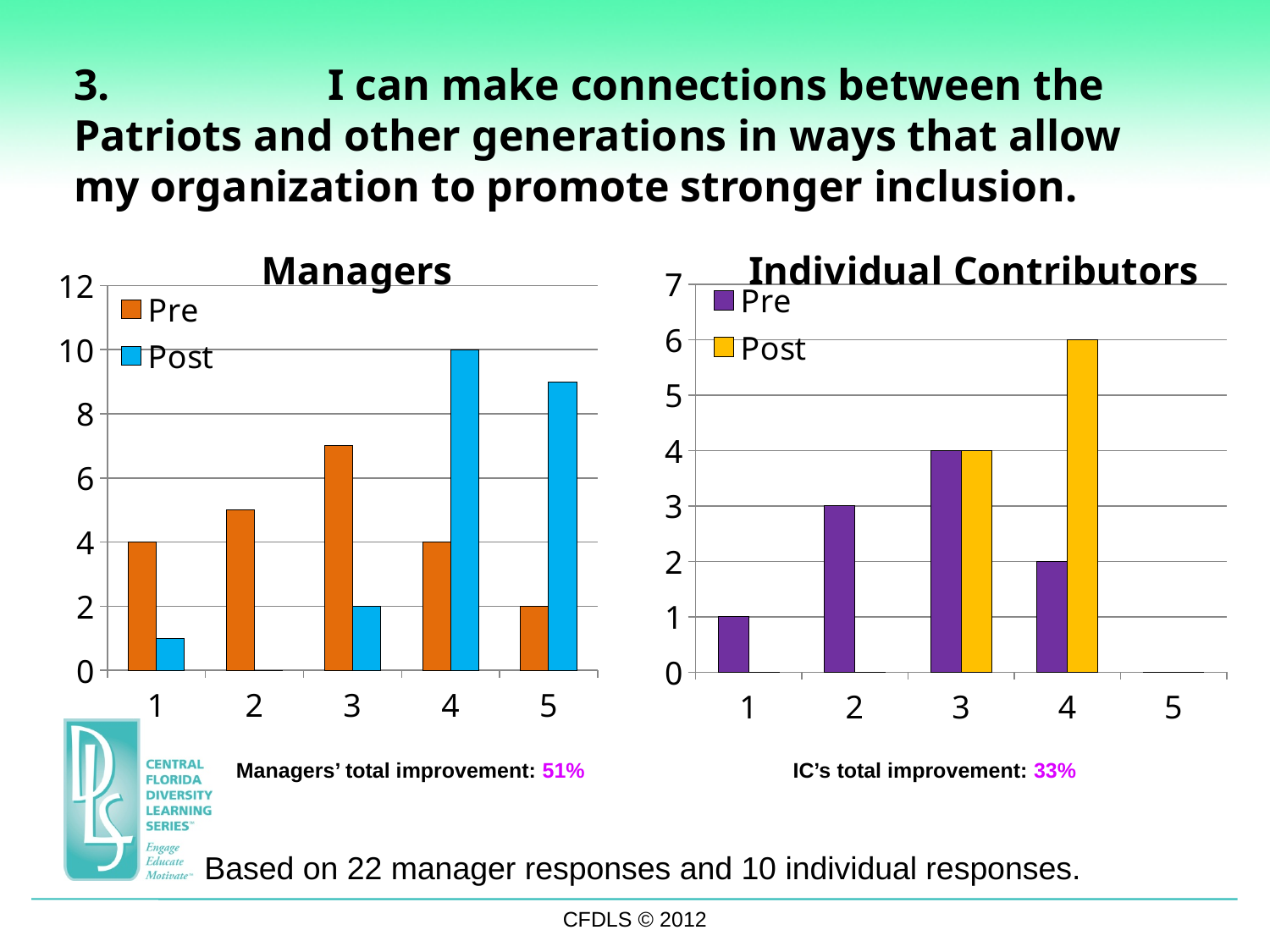
On the Managers chart, for category 4, which is larger, the Pre value or the Post value? Post On the Managers chart, is the Pre value for category 3 greater or less than 6? greater What kind of chart is the Managers chart? Bar chart On the Managers chart, which category has the highest Post value? 4 On the Individual Contributors chart, what is the Pre value for category 2? 3 On the Individual Contributors chart, which category has the highest Pre value? 3 On the Managers chart, what is the Post value for category 4? 10 On the Managers chart, is the Post value for category 5 greater or less than 8? greater On the Individual Contributors chart, what is the Post value for category 4? 6 How many categories are shown on the x axis of the Individual Contributors chart? 5 On the Individual Contributors chart, what is the difference between the Post and Pre values for category 4? 4 On the Managers chart, what is the Pre value for category 1? 4